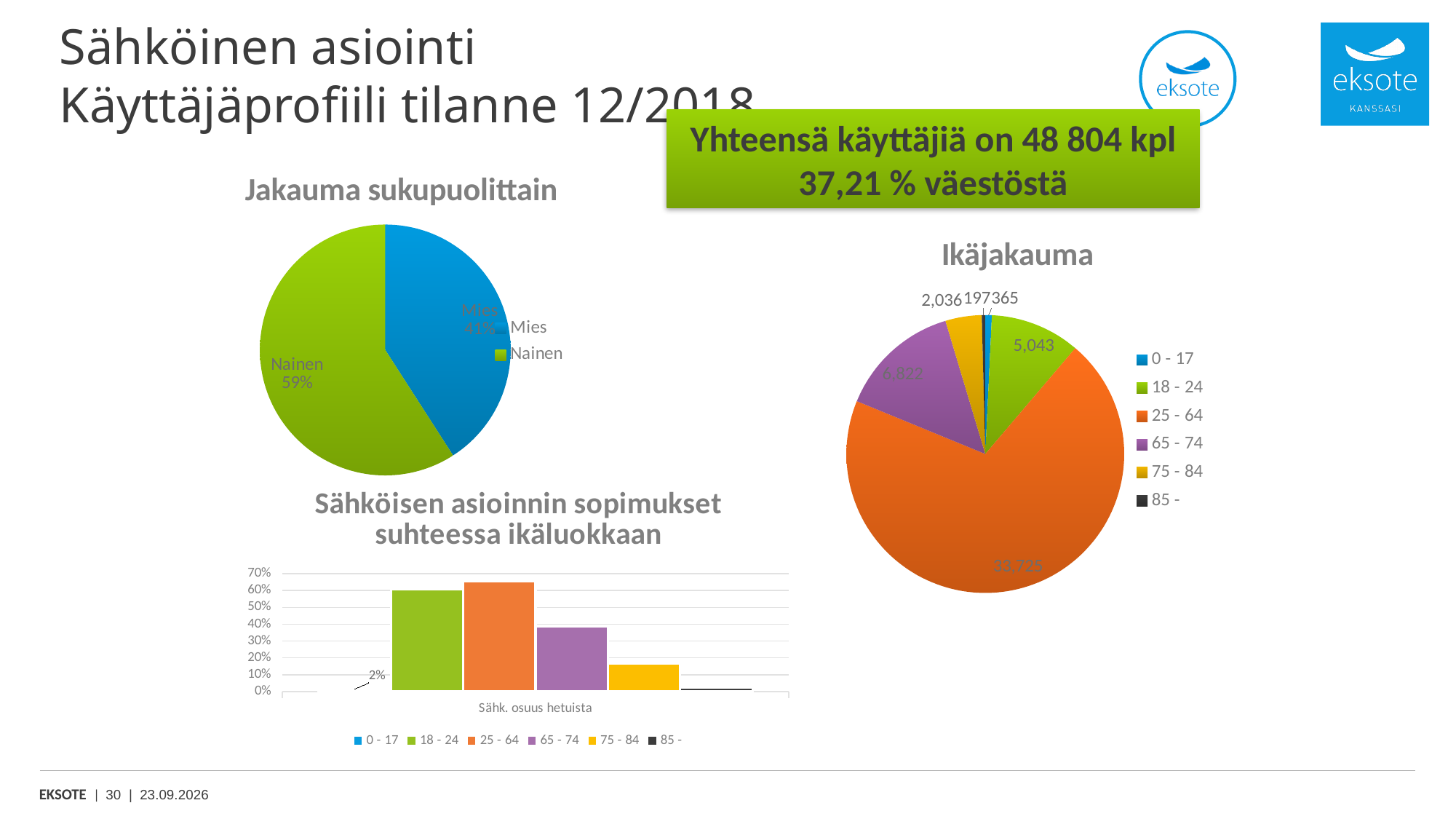
In the 'Jakauma sukupuolittain' pie chart, which slice is larger, Mies or Nainen? Nainen In the 'Ikäjakauma' pie chart, what is the value for the 65 - 74 age group? 6,822 In the 'Ikäjakauma' pie chart, what is the difference between the 65 - 74 and 18 - 24 values? 1,779 In the 'Jakauma sukupuolittain' pie chart, what share is Mies? 41% What kind of chart is 'Sähköisen asioinnin sopimukset suhteessa ikäluokkaan'? bar chart In the 'Ikäjakauma' pie chart, what is the value for the 25 - 64 age group? 33,725 In the 'Jakauma sukupuolittain' pie chart, what share is Nainen? 59% In the 'Sähköisen asioinnin sopimukset suhteessa ikäluokkaan' bar chart, what is the value for the 0 - 17 group? 2% In the 'Ikäjakauma' pie chart, what is the value for the 18 - 24 age group? 5,043 How many age groups does the legend of the 'Ikäjakauma' pie chart list? 6 In the 'Ikäjakauma' pie chart, which age group has the largest slice? 25 - 64